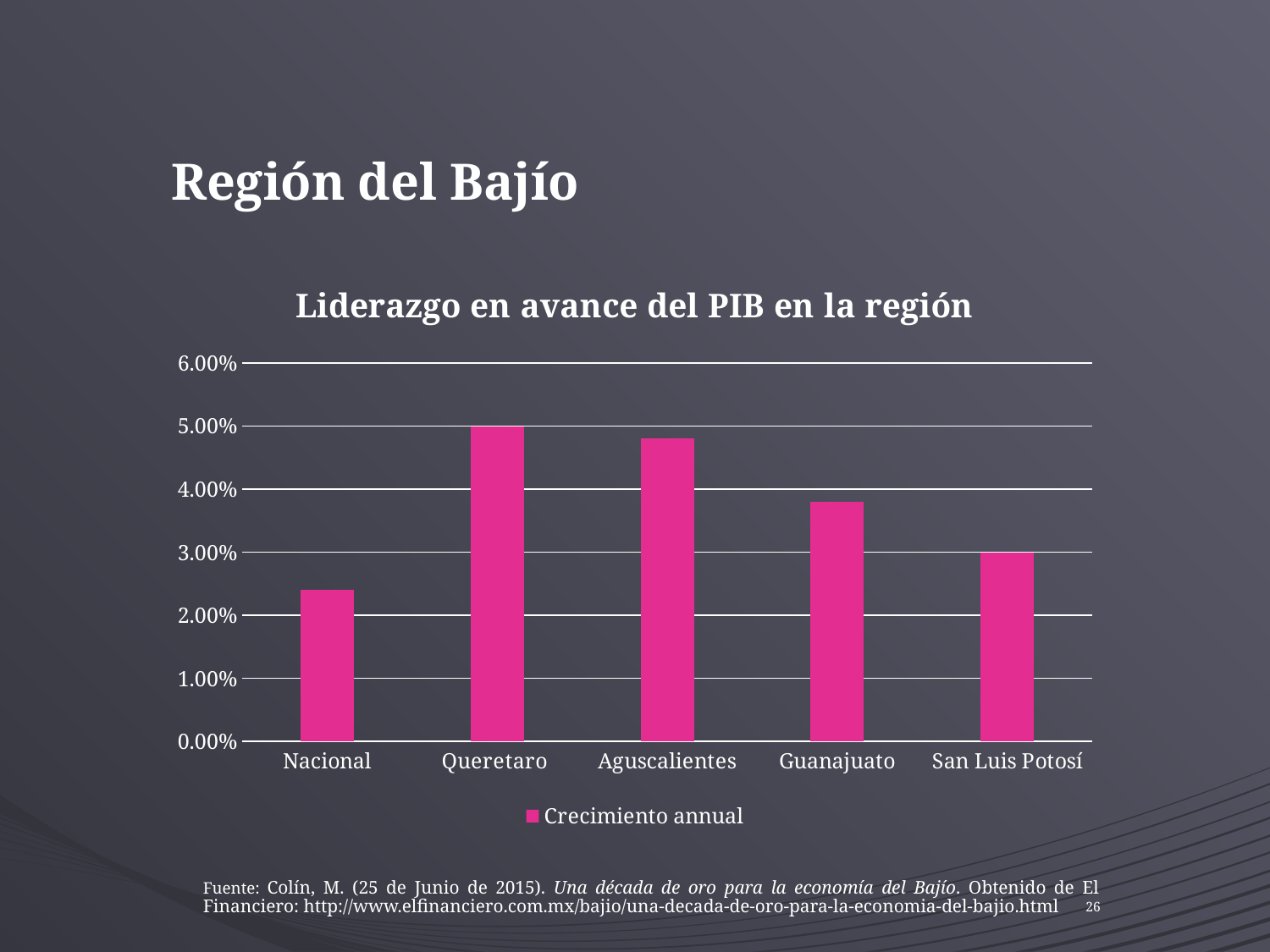
How many series does the chart legend list? 1 What kind of chart is shown on the slide? Bar chart Which category has the highest value in the chart? Queretaro What is the value for San Luis Potosí? 3.00% How many categories are shown on the x axis of the chart? 5 What is the value for Queretaro? 5.00% Is the value for Aguscalientes greater or less than 4.00%? greater Which category has the lowest value in the chart? Nacional What is the title of the chart? Liderazgo en avance del PIB en la región What is the name of the series shown in the legend? Crecimiento annual Which is larger, the value for Aguscalientes or the value for Guanajuato? Aguscalientes Is the value for Nacional greater or less than 3.00%? less